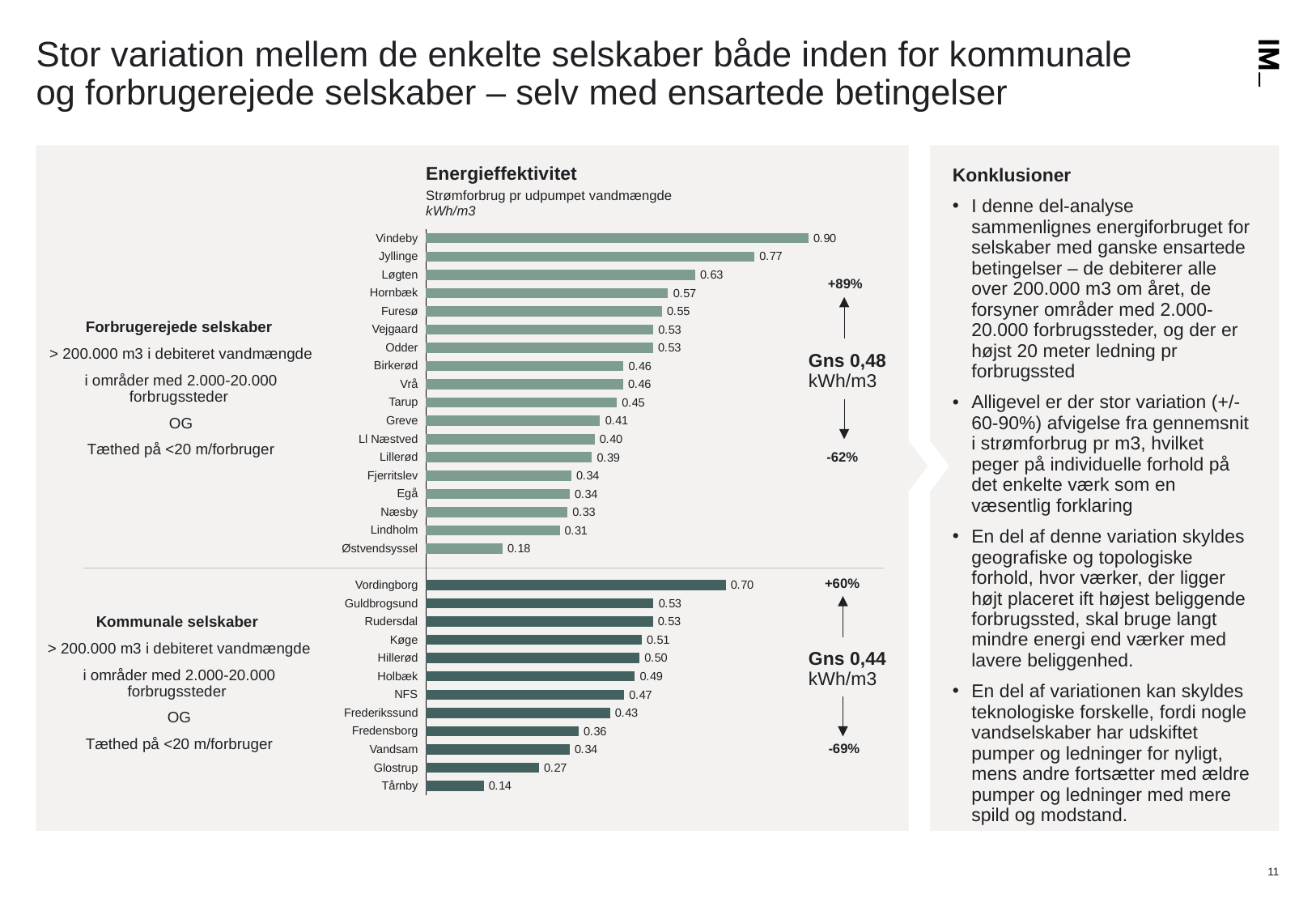
What is the difference between the values for Vindeby and Østvendsyssel in the Energieffektivitet chart? 0.72 How many companies are shown in the Kommunale selskaber group of the Energieffektivitet chart? 12 Which has a larger value in the Energieffektivitet chart, Jyllinge or Vordingborg? Jyllinge How many companies are shown in the Forbrugerejede selskaber group of the Energieffektivitet chart? 18 What type of chart is used to show Energieffektivitet? Bar chart Which company has the lowest value among the Kommunale selskaber in the Energieffektivitet chart? Tårnby Which company has the lowest value among the Forbrugerejede selskaber in the Energieffektivitet chart? Østvendsyssel Which company has the highest value among the Forbrugerejede selskaber in the Energieffektivitet chart? Vindeby What is the value for Vindeby in the Energieffektivitet chart? 0.90 What is the difference between the values for Vordingborg and Tårnby in the Energieffektivitet chart? 0.56 What is the value for Frederikssund in the Energieffektivitet chart? 0.43 What is the value for Tårnby in the Energieffektivitet chart? 0.14